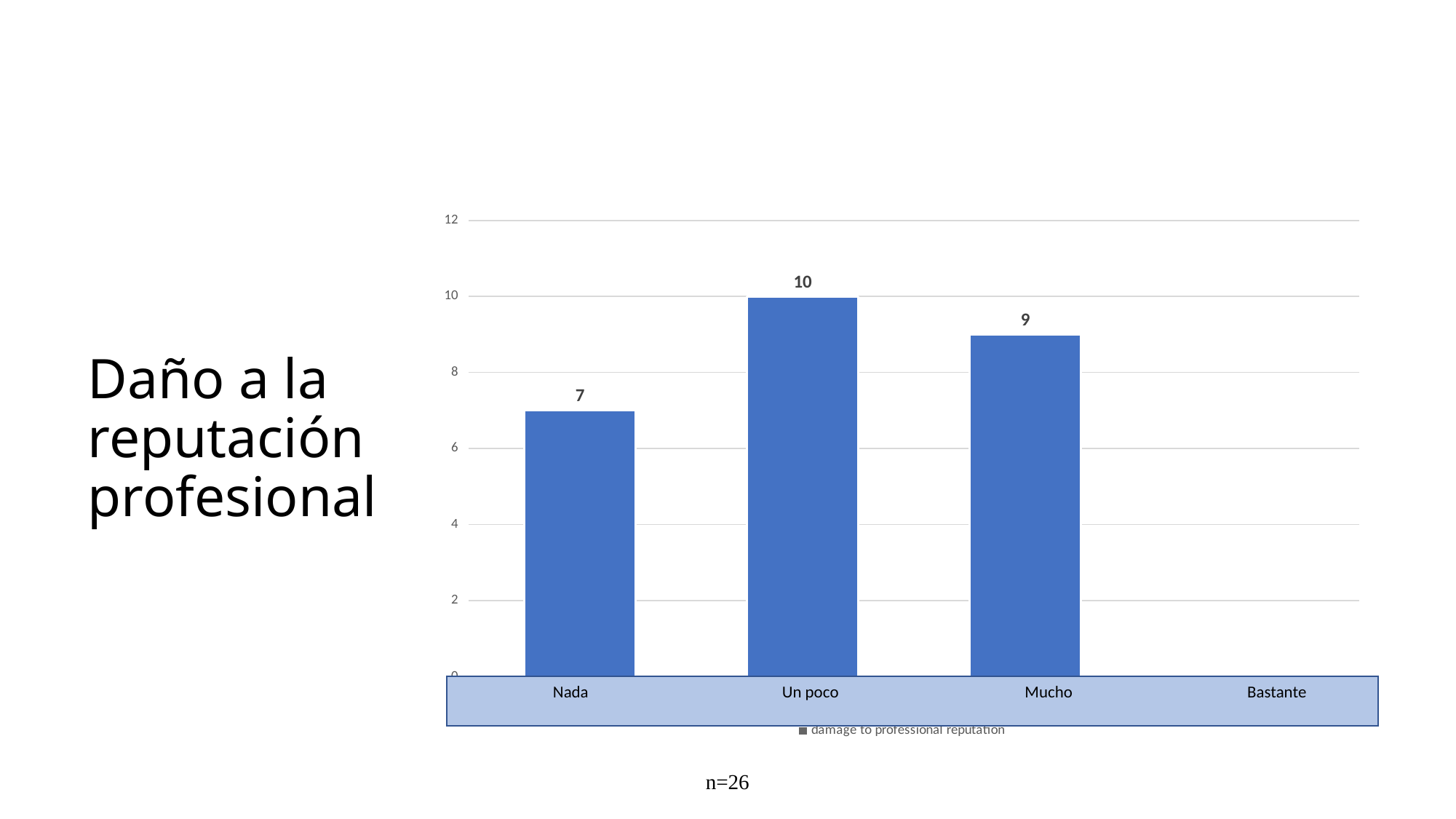
What kind of chart is shown on the slide? bar chart What is the value for Mucho? 9 What is the value for Un poco? 10 What is the value for Nada? 7 What is the title text shown on the slide next to the chart? Daño a la reputación profesional How many series does the legend list? 1 What is the difference between the values for Un poco and Nada? 3 How many categories are shown on the x axis? 4 Which is larger, the value for Mucho or the value for Nada? Mucho What is the difference between the values for Mucho and Nada? 2 Is the value for Nada greater or less than 8? less Which category has the highest value? Un poco